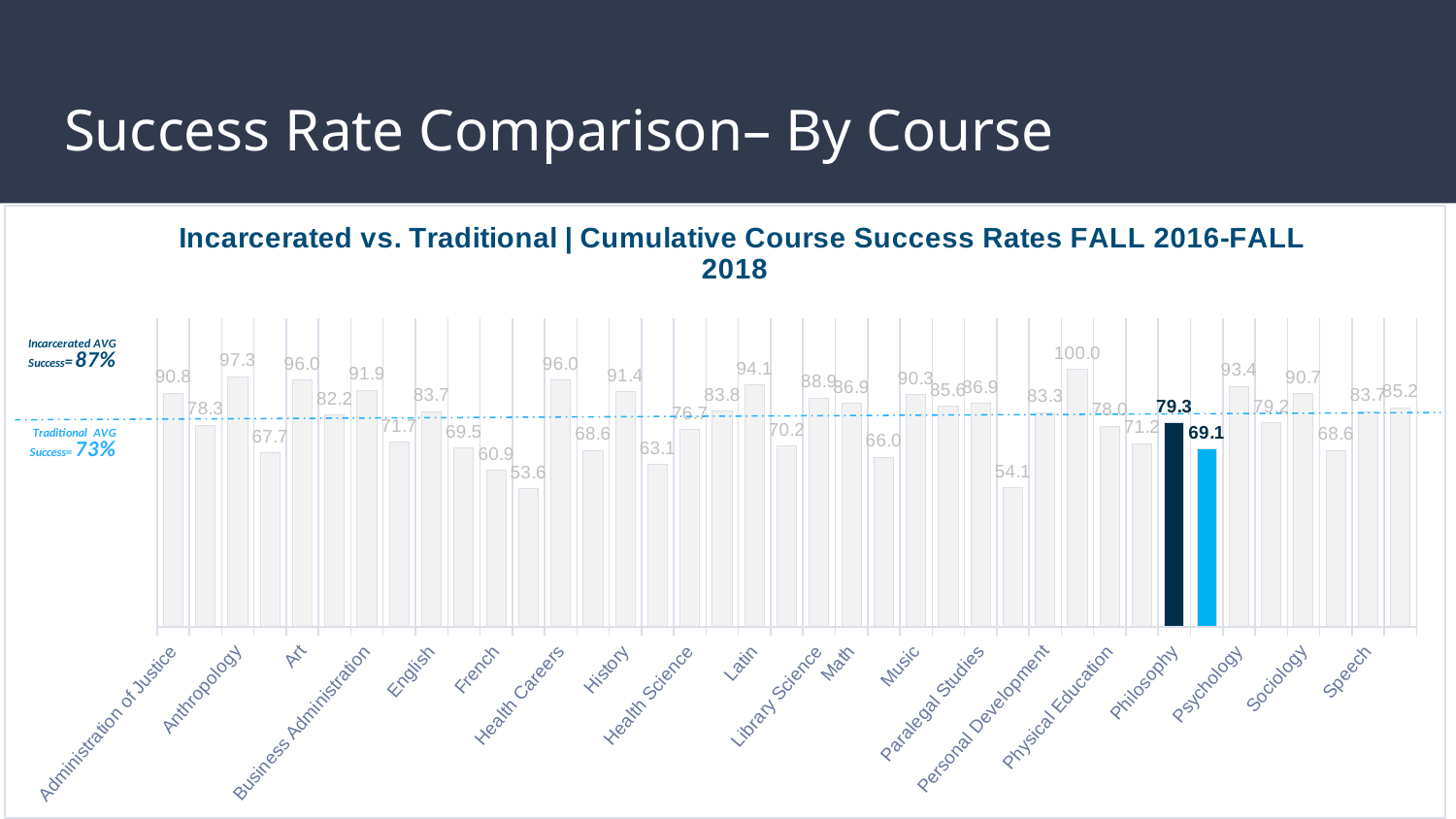
Which is larger, the Incarcerated AVG Success or the Traditional AVG Success? Incarcerated AVG Success What kind of chart is shown on the slide? bar chart What is the Traditional AVG Success rate shown on the chart? 73% How many courses are listed along the x axis of the chart? 20 What is the value of the dark navy highlighted bar for Philosophy? 79.3 What is the highest value labeled on any bar in the chart? 100.0 What is the difference between the two highlighted Philosophy bars (79.3 and 69.1)? 10.2 What is the title of the chart? Incarcerated vs. Traditional | Cumulative Course Success Rates FALL 2016-FALL 2018 What is the Incarcerated AVG Success rate shown on the chart? 87% What is the difference between the Incarcerated AVG Success and the Traditional AVG Success? 14 percentage points What is the lowest value labeled on any bar in the chart? 53.6 What is the value of the light blue highlighted bar for Philosophy? 69.1